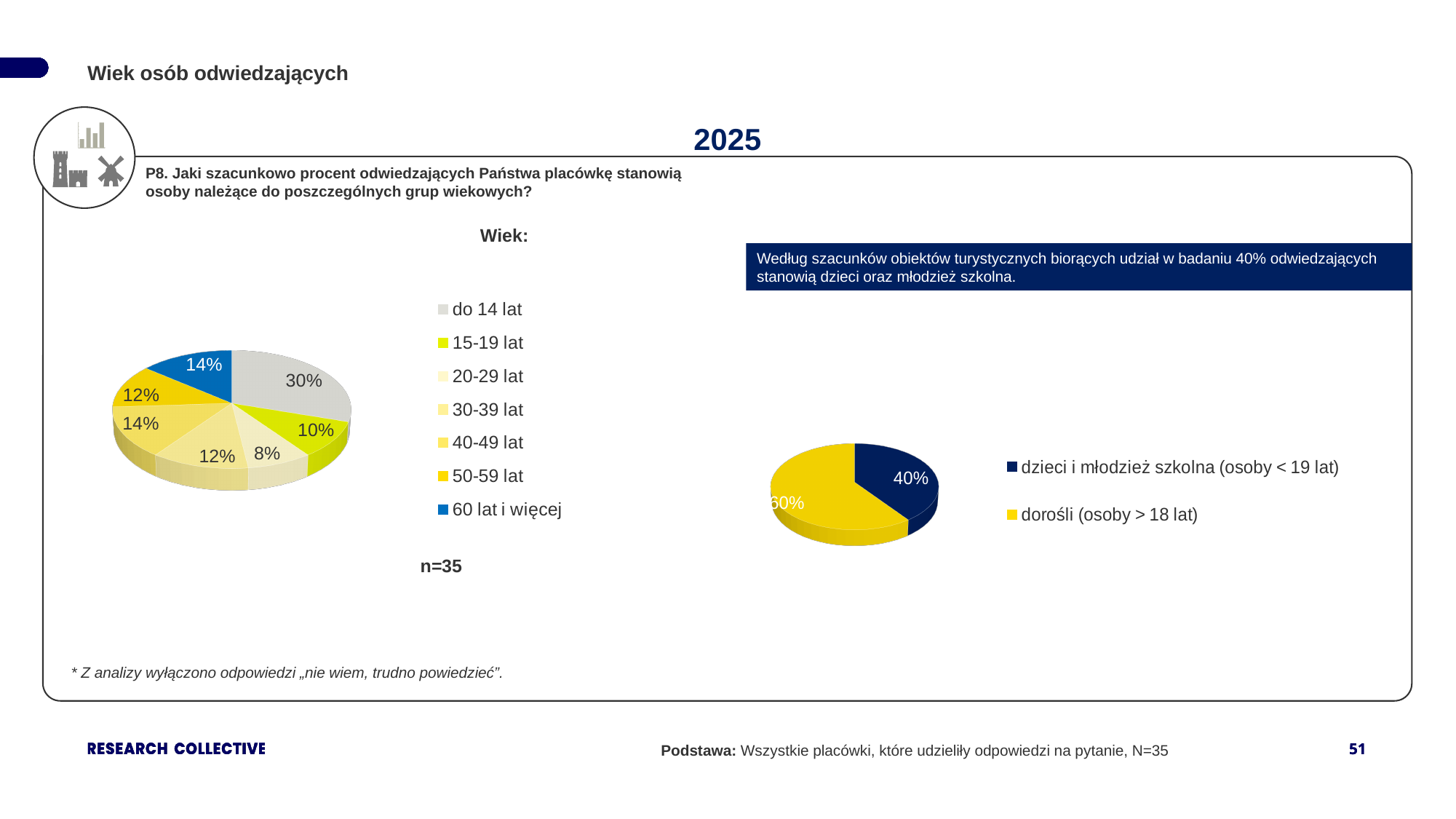
On the left pie chart (Wiek), what percentage is shown for '20-29 lat'? 8% On the left pie chart (Wiek), which age group has the largest share? do 14 lat On the left pie chart (Wiek), which is larger: the share for '40-49 lat' or '50-59 lat'? 40-49 lat On the right pie chart, what percentage is shown for 'dorośli (osoby > 18 lat)'? 60% On the right pie chart, what percentage is shown for 'dzieci i młodzież szkolna (osoby < 19 lat)'? 40% What sample size (n) is stated below the left pie chart? n=35 On the left pie chart (Wiek), which age group has the smallest share? 20-29 lat On the left pie chart (Wiek), what percentage is shown for '60 lat i więcej'? 14% On the left pie chart (Wiek), what is the difference between the shares for 'do 14 lat' and '15-19 lat'? 20% How many age groups are shown on the left pie chart (Wiek)? 7 What type of chart is used on the right side of the slide? Pie chart On the left pie chart (Wiek), what percentage is shown for 'do 14 lat'? 30%